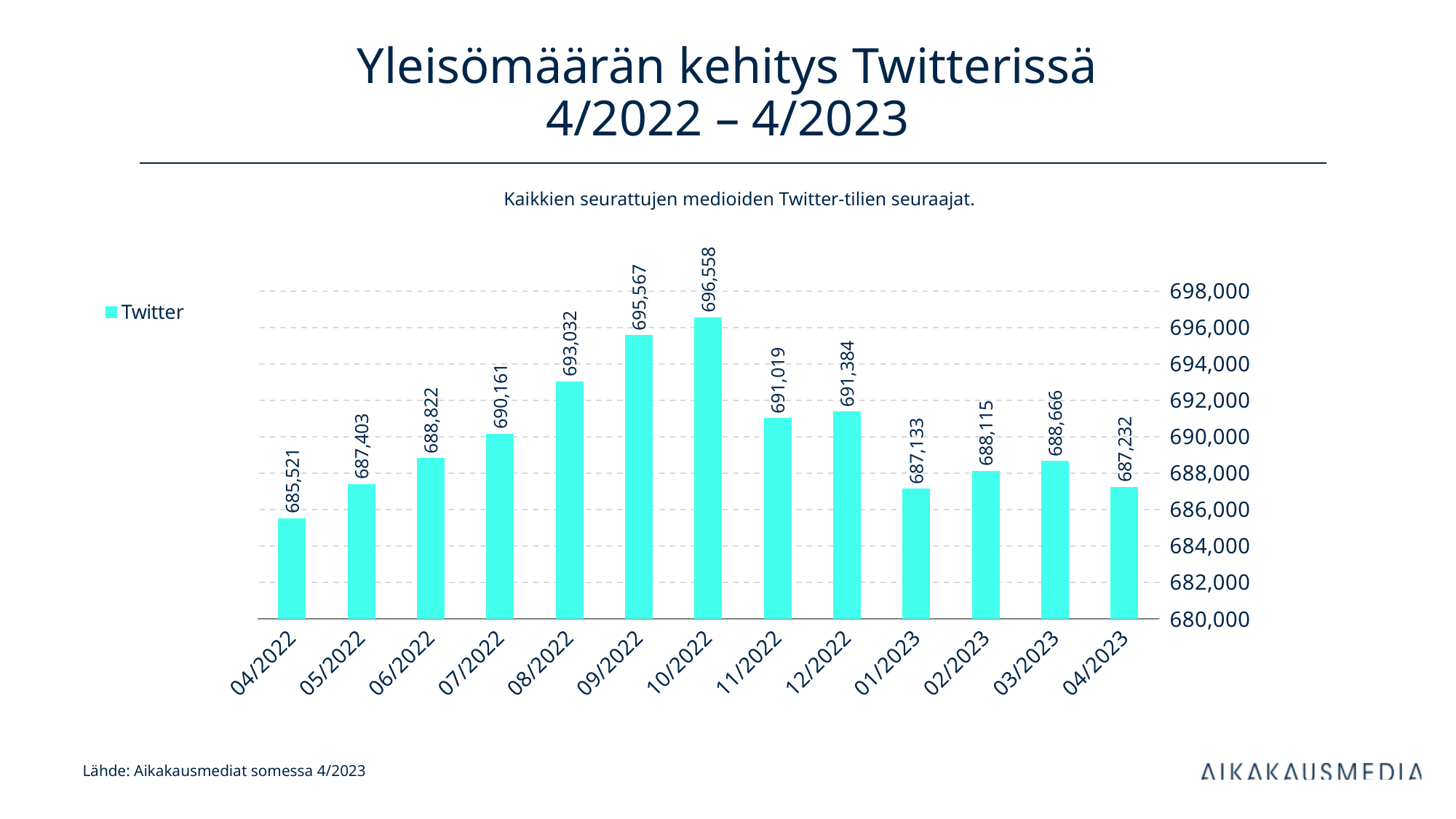
Which is larger, the value for 08/2022 or the value for 12/2022? 08/2022 Is the value for 09/2022 greater or less than 694,000? greater What kind of chart is shown on the slide? bar chart What is the difference between the values for 09/2022 and 08/2022? 2,535 Which month has the lowest value? 04/2022 What is the value for 04/2022? 685,521 What is the difference between the values for 10/2022 and 04/2022? 11,037 What is the value for 10/2022? 696,558 How many months are shown on the x axis? 13 What series does the legend list? Twitter Which month has the highest value? 10/2022 What is the value for 01/2023? 687,133